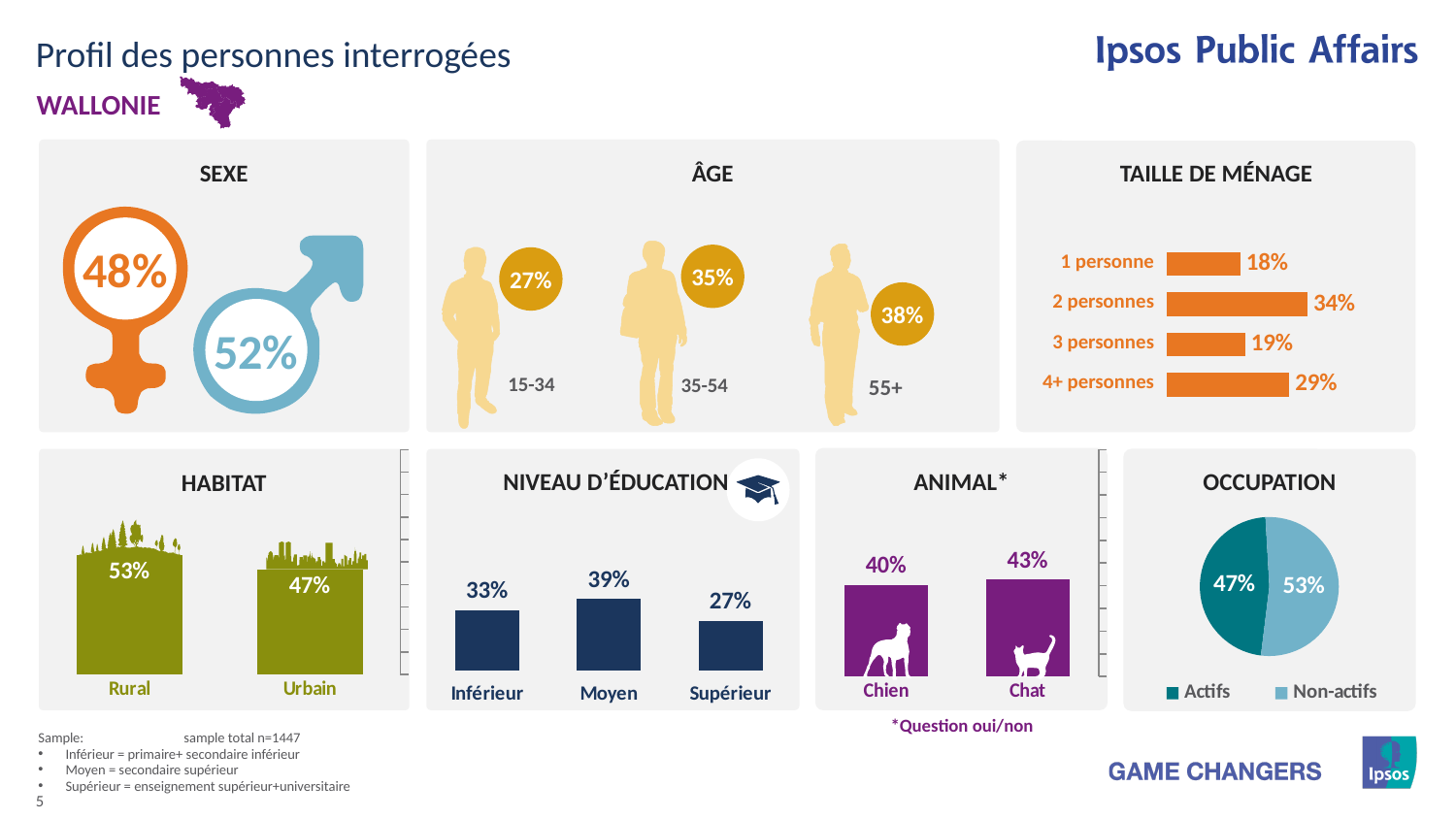
In the TAILLE DE MÉNAGE chart, what is the value for 2 personnes? 34% In the ANIMAL chart, which is larger, Chien or Chat? Chat In the OCCUPATION pie chart, what share is Non-actifs? 53% In the NIVEAU D'ÉDUCATION chart, which category is the highest? Moyen In the TAILLE DE MÉNAGE chart, which household size has the lowest value? 1 personne In the TAILLE DE MÉNAGE chart, what is the difference between 4+ personnes and 3 personnes? 10% What kind of chart is the OCCUPATION chart? pie chart In the HABITAT chart, what is the value for Rural? 53% In the NIVEAU D'ÉDUCATION chart, what is the value for Moyen? 39% What kind of chart is the NIVEAU D'ÉDUCATION chart? bar chart How many categories does the TAILLE DE MÉNAGE chart show? 4 In the ANIMAL chart, what is the difference between Chat and Chien? 3%